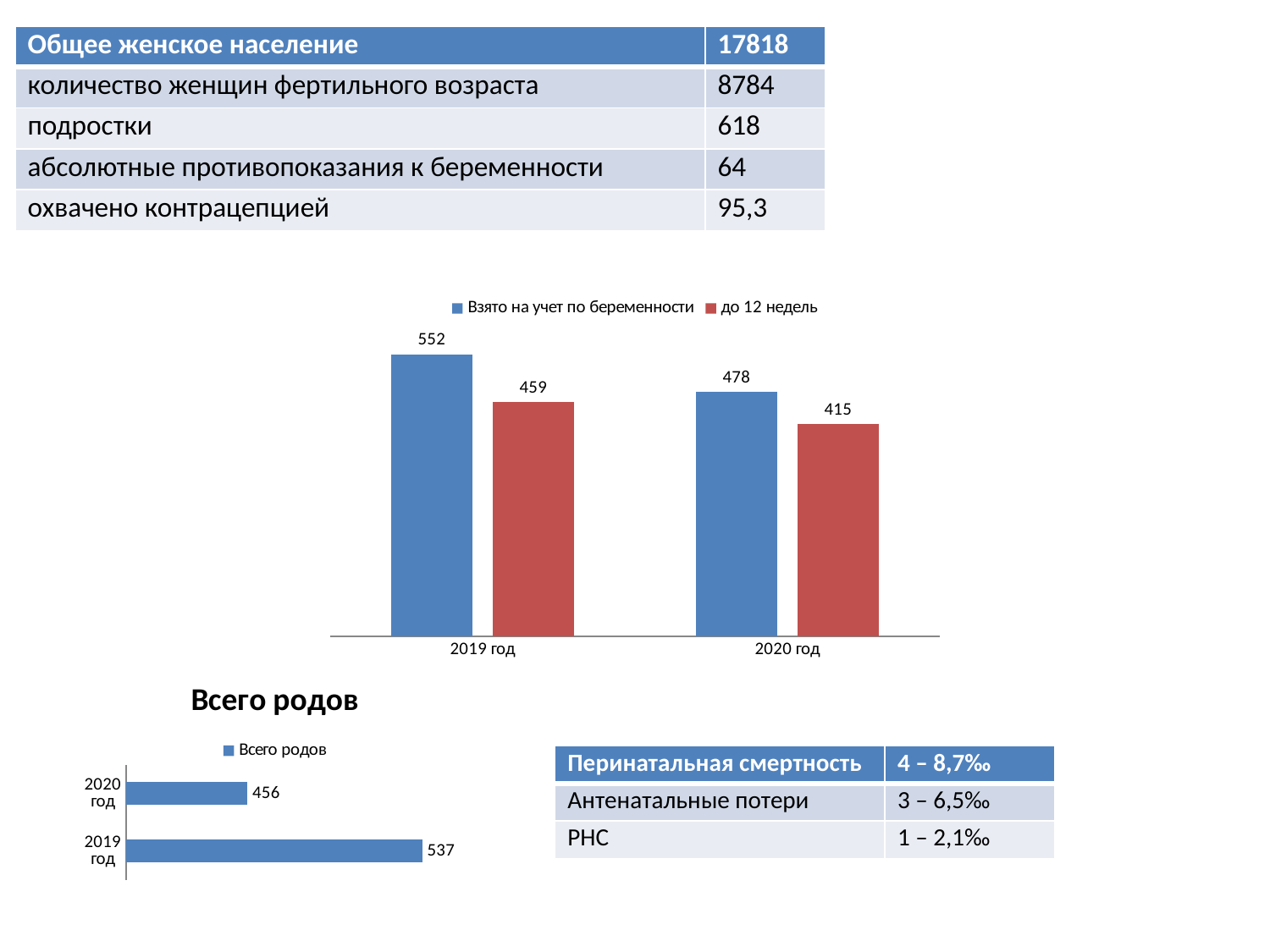
In the middle chart (legend 'Взято на учет по беременности' / 'до 12 недель'), what is the difference between 'Взято на учет по беременности' and 'до 12 недель' in 2020 год? 63 In the middle chart (legend 'Взято на учет по беременности' / 'до 12 недель'), what is the value of 'до 12 недель' for 2019 год? 459 In the middle chart (legend 'Взято на учет по беременности' / 'до 12 недель'), what is the value of 'Взято на учет по беременности' for 2019 год? 552 In the middle chart (legend 'Взято на учет по беременности' / 'до 12 недель'), what is the value of 'до 12 недель' for 2020 год? 415 In the middle chart (legend 'Взято на учет по беременности' / 'до 12 недель'), which year has the higher value for 'Взято на учет по беременности'? 2019 год In the chart titled 'Всего родов', what is the value for 2020 год? 456 In the chart titled 'Всего родов', what is the value for 2019 год? 537 What kind of chart is the chart titled 'Всего родов'? bar chart In the middle chart (legend 'Взято на учет по беременности' / 'до 12 недель'), how many series does the legend list? 2 In the middle chart (legend 'Взято на учет по беременности' / 'до 12 недель'), does the value of 'Взято на учет по беременности' rise or fall from 2019 год to 2020 год? fall In the middle chart (legend 'Взято на учет по беременности' / 'до 12 недель'), what colour are the bars for 'до 12 недель'? red In the chart titled 'Всего родов', what is the difference between the 2019 год and 2020 год values? 81